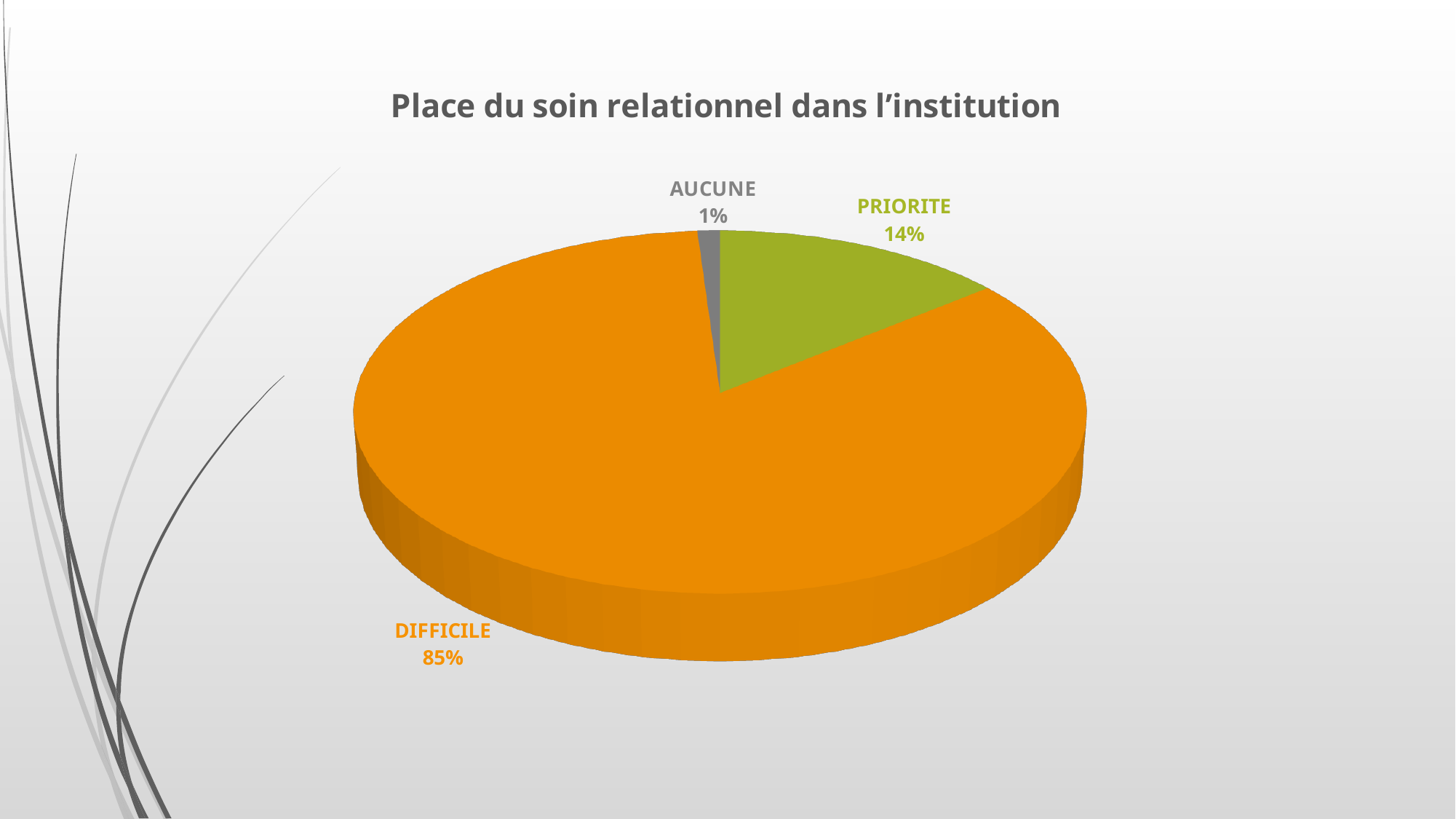
How many categories are shown in the pie chart? 3 What is the difference in percentage points between PRIORITE and AUCUNE? 13 What share of the pie does DIFFICILE represent? 85% What colour is the DIFFICILE slice? Orange What share of the pie does PRIORITE represent? 14% Which is larger, the share for PRIORITE or the share for AUCUNE? PRIORITE What share of the pie does AUCUNE represent? 1% What is the title of the chart? Place du soin relationnel dans l’institution Which category has the largest slice of the pie? DIFFICILE Which category has the smallest slice of the pie? AUCUNE What is the difference in percentage points between DIFFICILE and PRIORITE? 71 What kind of chart is shown on the slide? Pie chart